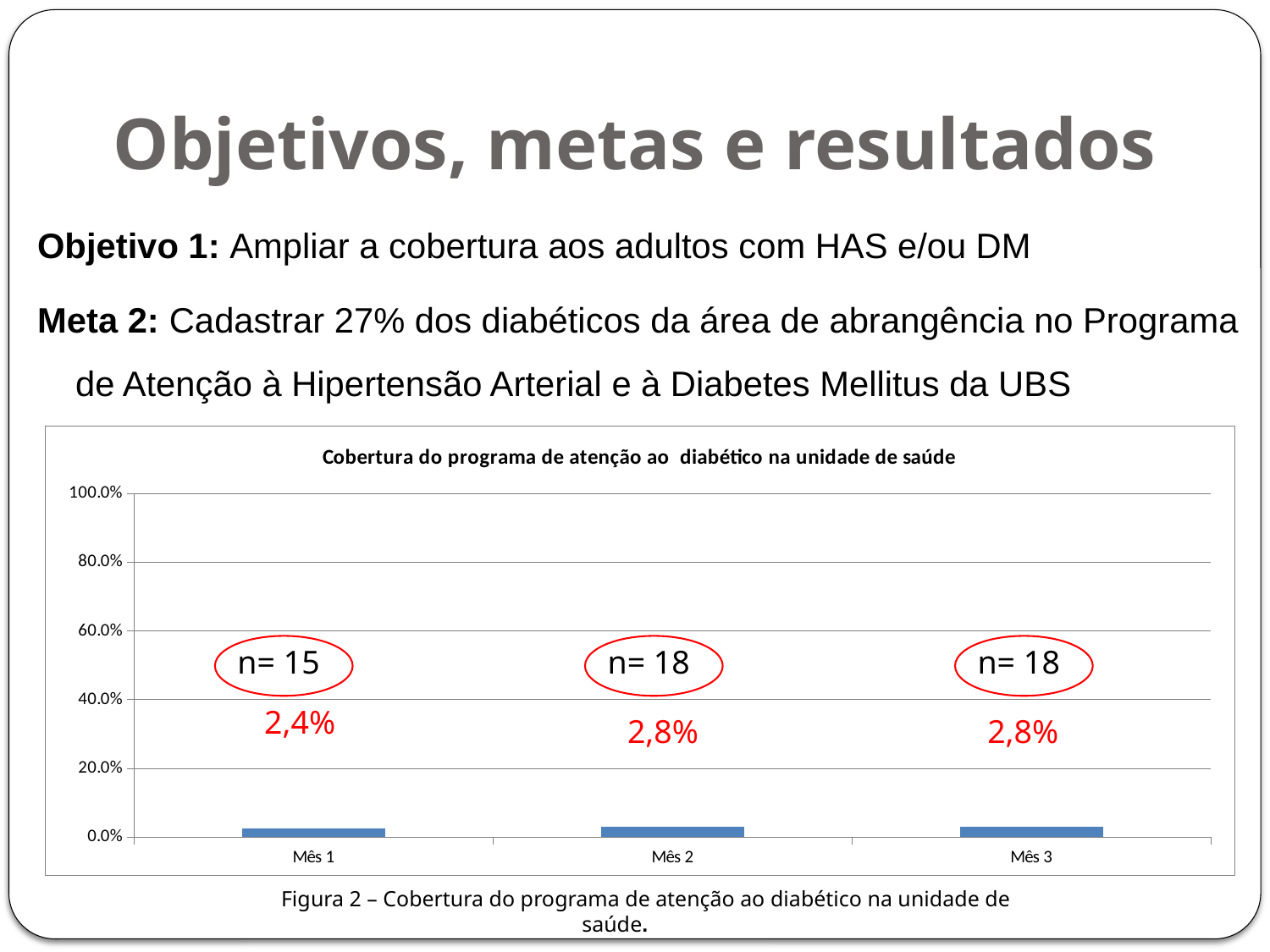
Is the value for Mês 3 greater or less than 20.0%? less Which month has the lowest coverage value? Mês 1 What is the coverage value labelled for Mês 3? 2,8% What is the coverage value labelled for Mês 2? 2,8% How many categories (months) are shown on the x axis of the chart? 3 Do the coverage values rise or fall from Mês 1 to Mês 2? rise What is the coverage value labelled for Mês 1? 2,4% Which is larger, the coverage value for Mês 1 or for Mês 2? Mês 2 What is the title of the chart? Cobertura do programa de atenção ao diabético na unidade de saúde What is the n value annotated above the bar for Mês 1? n= 15 What is the difference between the coverage values for Mês 2 and Mês 1? 0,4% What kind of chart is shown on the slide? Bar chart